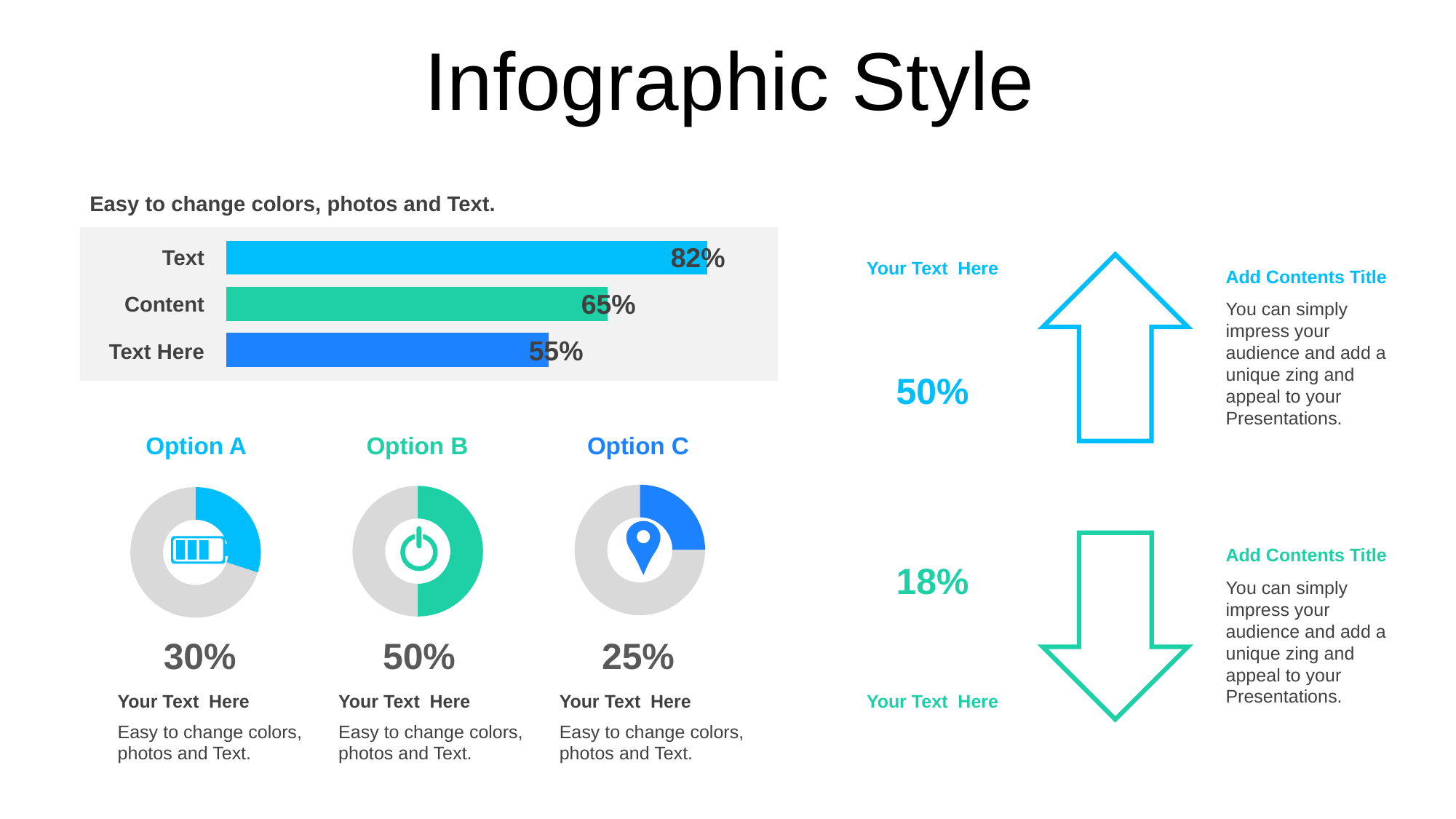
How many categories does the horizontal bar chart at the top left show? 3 What is the difference between the percentages shown for Option B and Option A in the donut charts? 20% In the horizontal bar chart at the top left, what is the value for Text Here? 55% What kind of chart is shown at the top left of the slide? Bar chart In the horizontal bar chart at the top left, what is the difference between the values for Text and Text Here? 27% In the donut chart labelled Option C, what percentage is shown? 25% In the horizontal bar chart at the top left, which category has the highest value? Text In the horizontal bar chart at the top left, which category has the lowest value? Text Here In the donut chart labelled Option A, what percentage is shown? 30% Among the three donut charts Option A, Option B and Option C, which shows the highest percentage? Option B In the horizontal bar chart at the top left, which is larger, the value for Content or the value for Text Here? Content In the horizontal bar chart at the top left, what is the value for Content? 65%